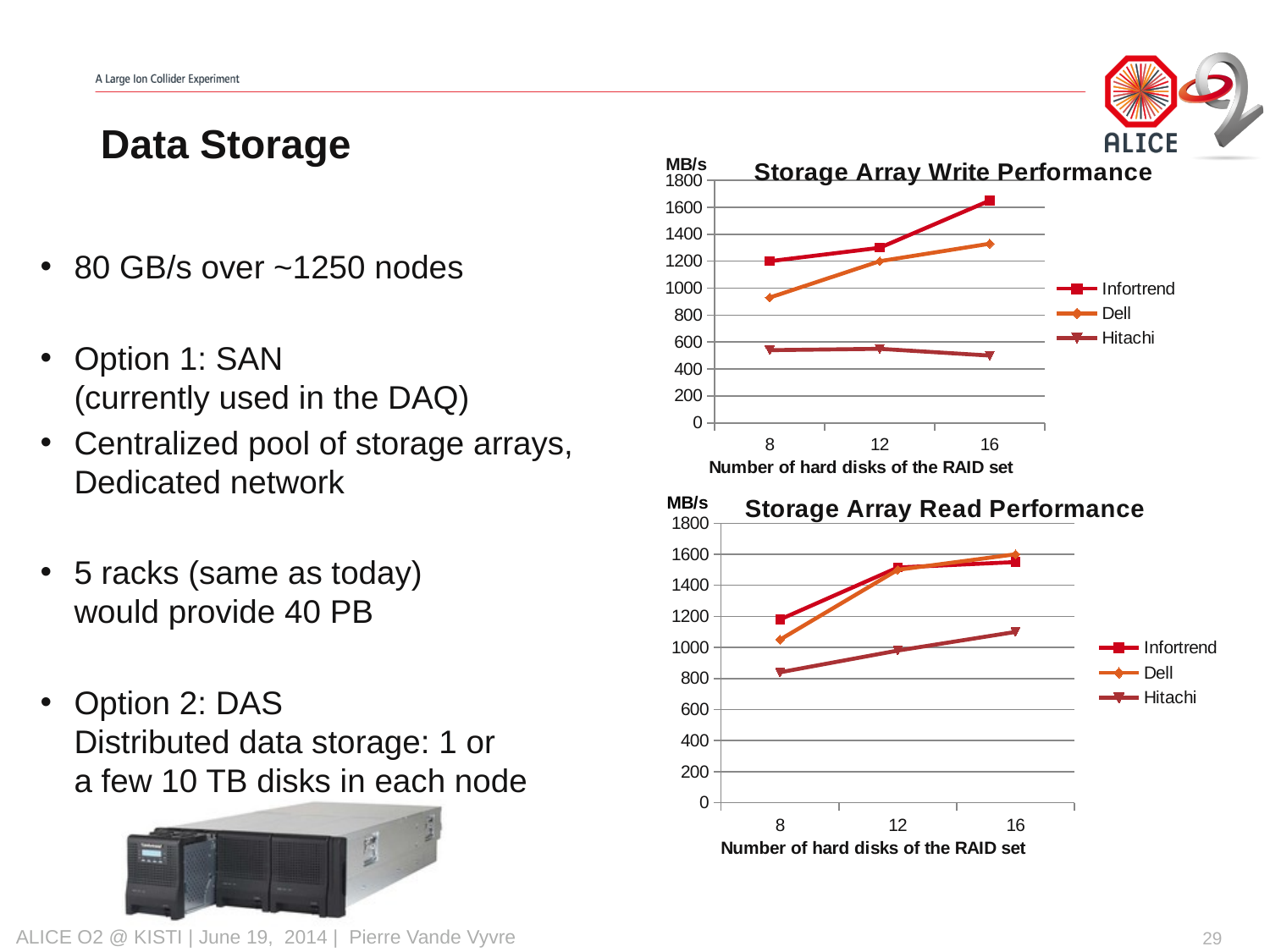
In the Storage Array Write Performance chart, is the value for Dell at 16 hard disks greater or less than 1400? less What is the x-axis label of the Storage Array Read Performance chart? Number of hard disks of the RAID set How many x-axis categories (numbers of hard disks) are shown in the Storage Array Write Performance chart? 3 In the Storage Array Read Performance chart, which series has the lowest value at 16 hard disks? Hitachi In the Storage Array Write Performance chart, does the Infortrend series rise or fall as the number of hard disks increases? rise In the Storage Array Read Performance chart, is the value for Hitachi at 16 hard disks greater or less than 1000? greater In the Storage Array Write Performance chart, is the value for Hitachi at 8 hard disks greater or less than 600? less In the Storage Array Write Performance chart, which series has the highest value at 16 hard disks? Infortrend In the Storage Array Read Performance chart, which is larger at 8 hard disks: Infortrend or Dell? Infortrend What type of chart is the Storage Array Write Performance chart? line chart In the Storage Array Write Performance chart, which series has the lowest value at 8 hard disks? Hitachi How many series does the legend of the Storage Array Read Performance chart list? 3